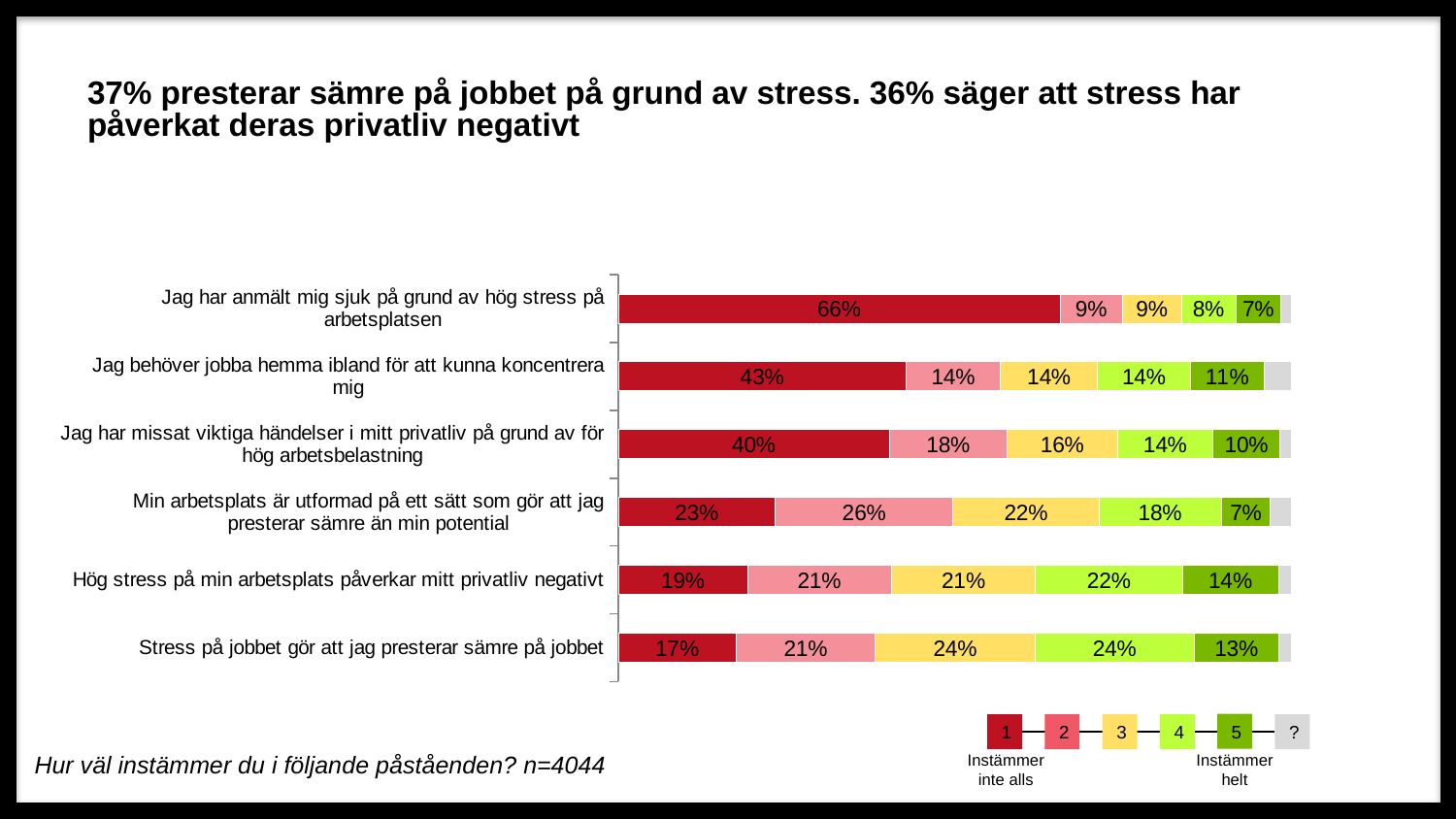
How many entries does the legend list? 6 What kind of chart is shown on the slide? Stacked bar chart Which statement has a larger share answering 5 (Instämmer helt): "Jag behöver jobba hemma ibland för att kunna koncentrera mig" or "Min arbetsplats är utformad på ett sätt som gör att jag presterar sämre än min potential"? Jag behöver jobba hemma ibland för att kunna koncentrera mig What percentage answered 5 (Instämmer helt) for "Stress på jobbet gör att jag presterar sämre på jobbet"? 13% What percentage answered 1 (Instämmer inte alls) for "Jag har anmält mig sjuk på grund av hög stress på arbetsplatsen"? 66% Which statement has the highest share of respondents answering 1 (Instämmer inte alls)? Jag har anmält mig sjuk på grund av hög stress på arbetsplatsen What is the sample size (n) stated on the slide? n=4044 How many statements are shown in the chart? 6 Which statement has the lowest share of respondents answering 1 (Instämmer inte alls)? Stress på jobbet gör att jag presterar sämre på jobbet What percentage answered 4 for "Hög stress på min arbetsplats påverkar mitt privatliv negativt"? 22% What percentage answered 2 for "Min arbetsplats är utformad på ett sätt som gör att jag presterar sämre än min potential"? 26% What is the difference in percentage points between the share answering 1 for "Jag har anmält mig sjuk på grund av hög stress på arbetsplatsen" (66%) and for "Jag behöver jobba hemma ibland för att kunna koncentrera mig" (43%)? 23 percentage points